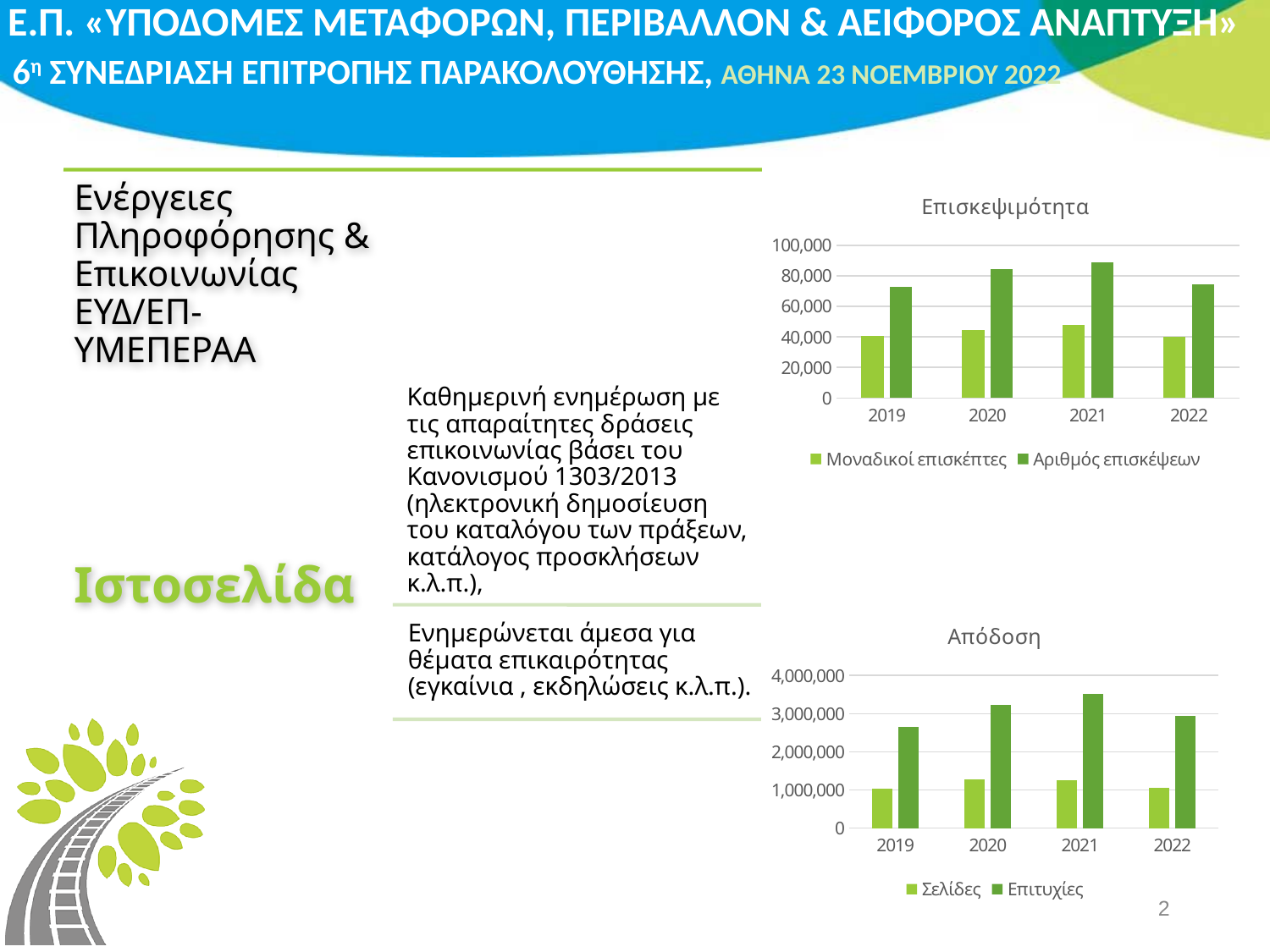
How many years are shown on the x axis of the 'Απόδοση' chart? 4 What is the title of the upper chart on the slide? Επισκεψιμότητα In the 'Επισκεψιμότητα' chart, which is larger for Αριθμός επισκέψεων: 2019 or 2020? 2020 In the 'Απόδοση' chart, is the value for Σελίδες in 2022 greater or less than 2,000,000? less In the 'Επισκεψιμότητα' chart, is the value for Μοναδικοί επισκέπτες in 2019 greater or less than 60,000? less What are the two legend entries of the 'Απόδοση' chart? Σελίδες and Επιτυχίες What kind of chart is the 'Επισκεψιμότητα' chart? bar chart In the 'Απόδοση' chart, which year has the highest value for Επιτυχίες? 2021 In the 'Επισκεψιμότητα' chart, is the value for Αριθμός επισκέψεων in 2021 greater or less than 80,000? greater In the 'Απόδοση' chart, which is larger for Επιτυχίες: 2019 or 2022? 2022 How many series does the legend of the 'Επισκεψιμότητα' chart list? 2